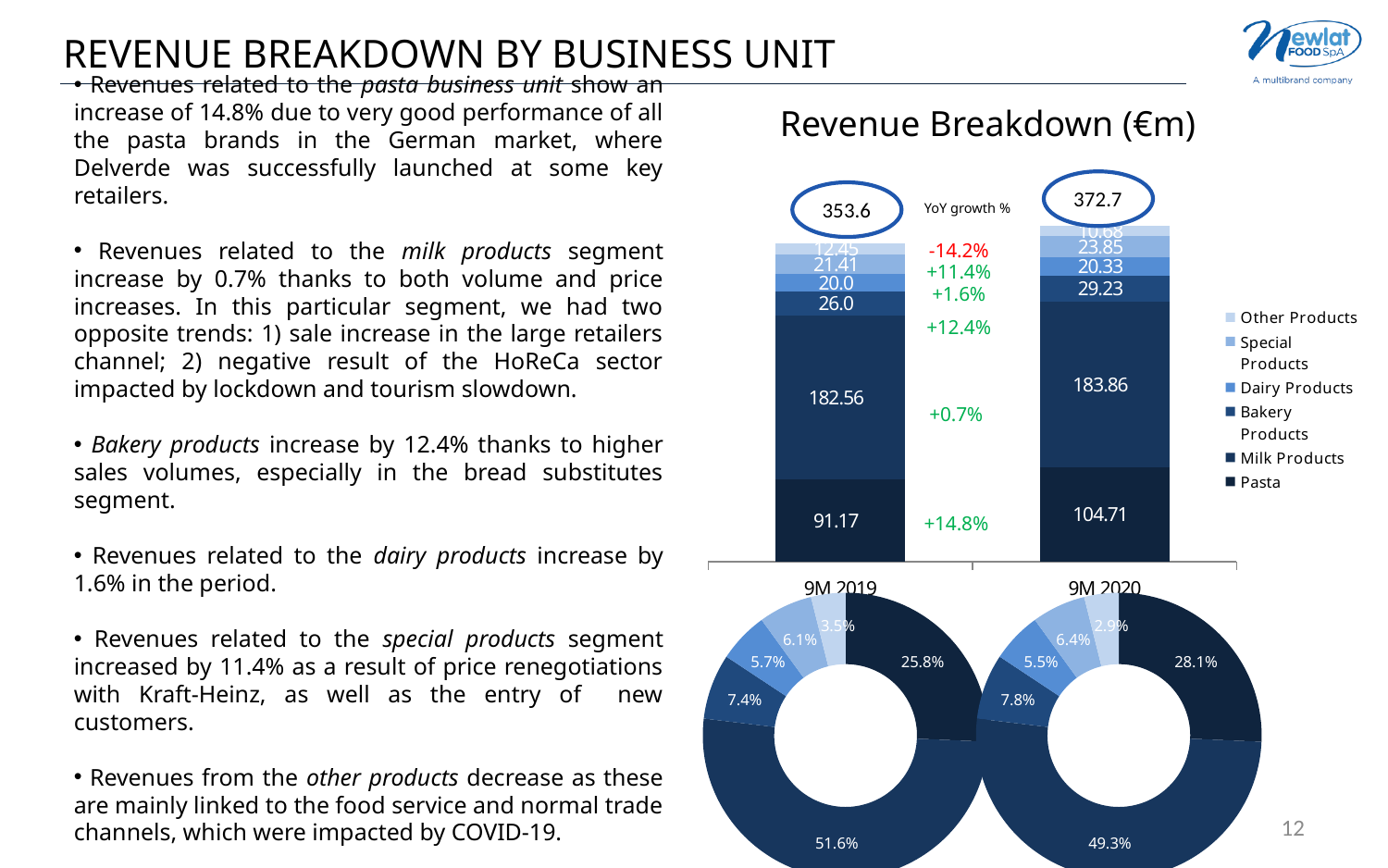
How many series does the legend of the Revenue Breakdown (€m) chart list? 6 In the Revenue Breakdown (€m) stacked bar chart, is the Bakery Products value larger in 9M 2019 or 9M 2020? 9M 2020 In the Revenue Breakdown (€m) stacked bar chart, what is the Pasta value for 9M 2020? 104.71 In the Revenue Breakdown (€m) stacked bar chart, which segment has the largest value in the 9M 2020 bar? Milk Products In the Revenue Breakdown (€m) stacked bar chart, what is the YoY growth % shown for Bakery Products? +12.4% In the Revenue Breakdown (€m) stacked bar chart, what is the YoY growth % shown for Pasta? +14.8% In the Revenue Breakdown (€m) stacked bar chart, what is the total shown for the 9M 2019 bar? 353.6 In the 9M 2020 donut chart, what share is shown for the largest slice? 49.3% In the Revenue Breakdown (€m) stacked bar chart, what is the total shown for the 9M 2020 bar? 372.7 In the 9M 2019 donut chart, what share is shown for the largest slice? 51.6% In the Revenue Breakdown (€m) stacked bar chart, what is the Milk Products value for 9M 2019? 182.56 In the Revenue Breakdown (€m) stacked bar chart, what is the difference between the Pasta values for 9M 2020 and 9M 2019? 13.54